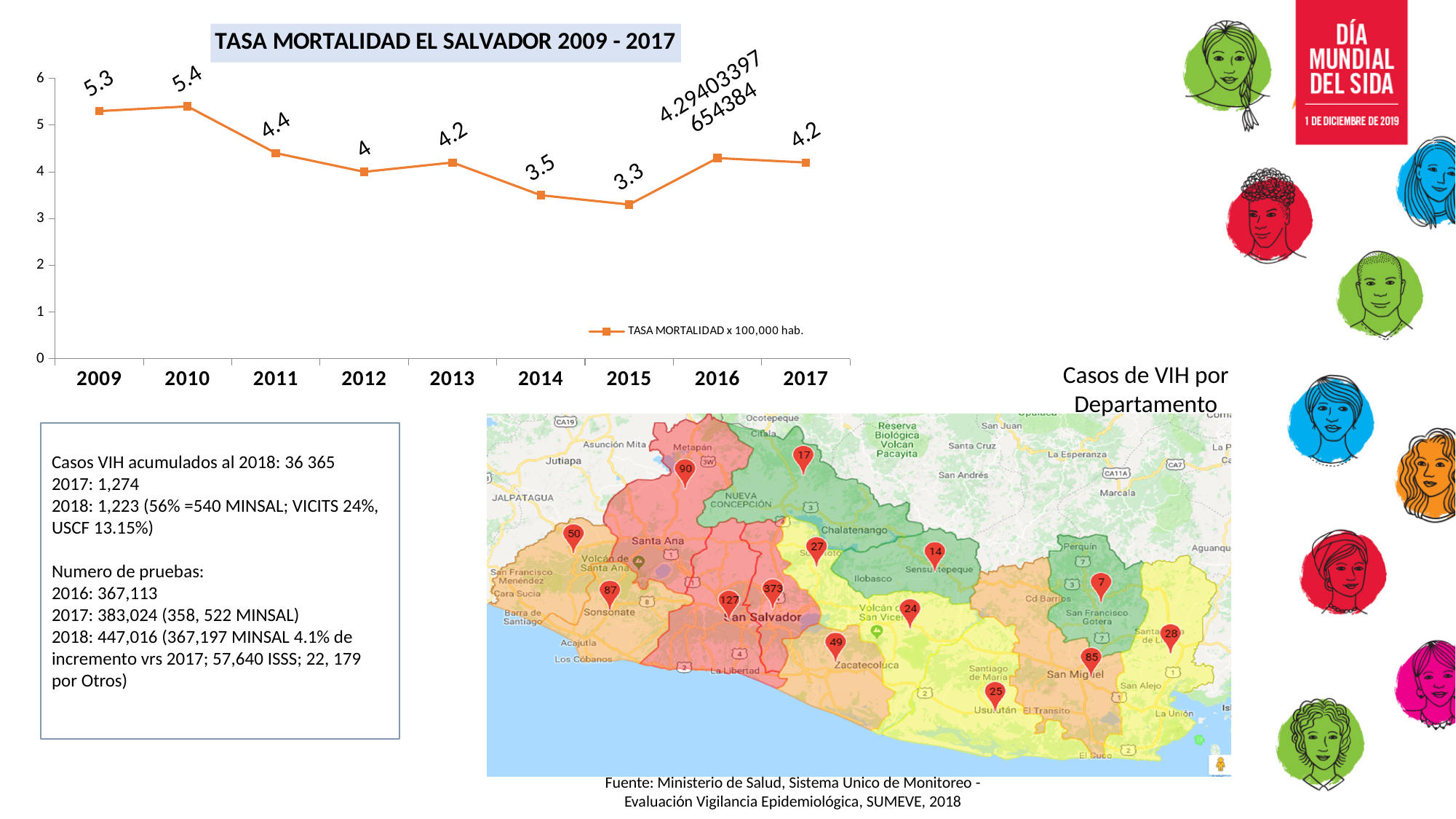
What value is labelled for 2012 on the mortality rate chart? 4 What kind of chart is 'TASA MORTALIDAD EL SALVADOR 2009 - 2017'? Line chart What is the difference between the mortality rate in 2009 and in 2015? 2 Which year has the highest mortality rate in the chart? 2010 What is the mortality rate shown for 2015? 3.3 What value is labelled for 2017 on the mortality rate chart? 4.2 Which year has the lowest mortality rate in the chart? 2015 Does the mortality rate rise or fall from 2010 to 2015? Fall Which year has a higher mortality rate, 2011 or 2013? 2011 How many series does the legend of the mortality rate chart list? 1 How many years are plotted on the mortality rate chart? 9 What is the mortality rate shown for 2009 in the chart 'TASA MORTALIDAD EL SALVADOR 2009 - 2017'? 5.3